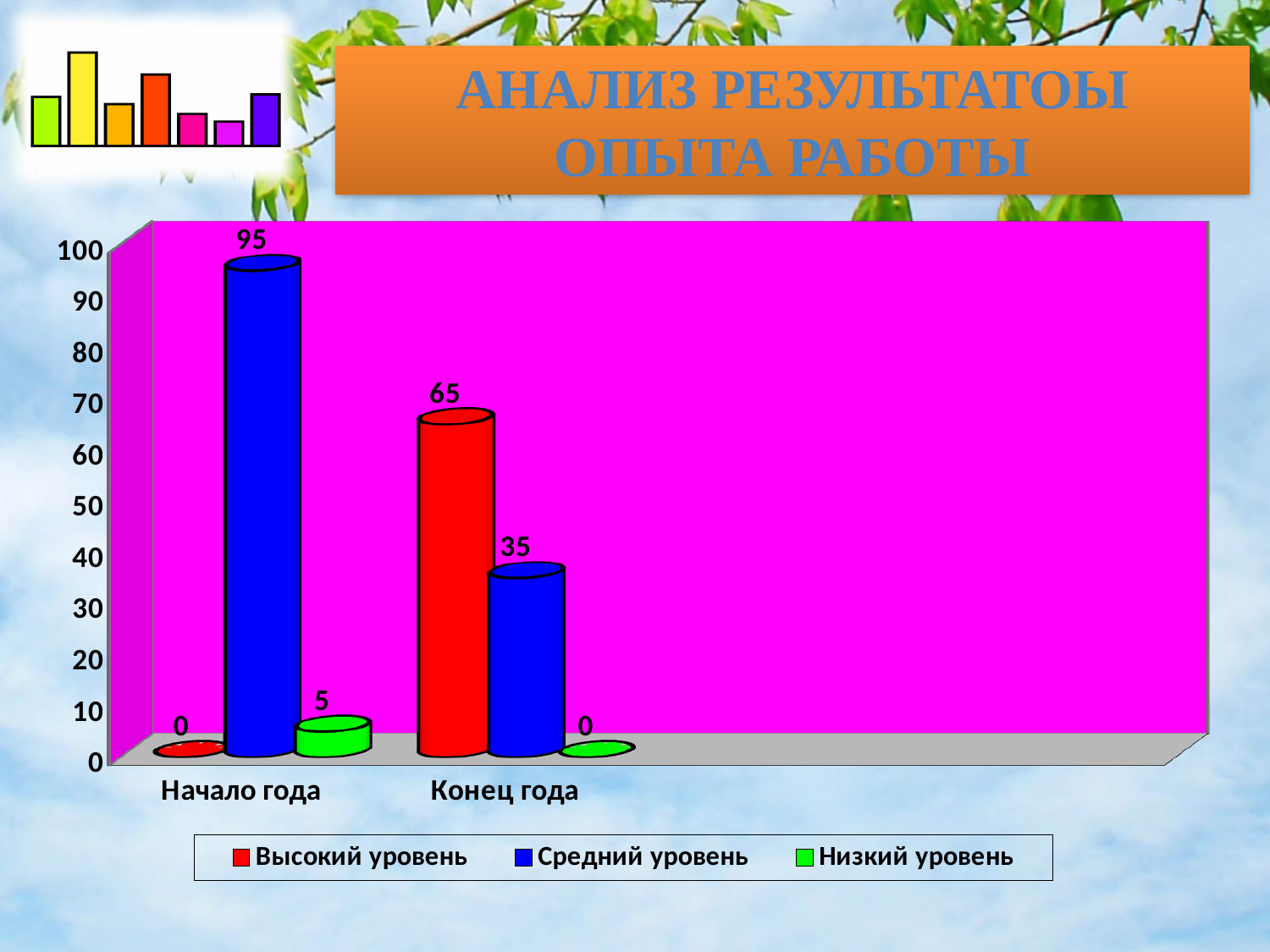
Which series has the lowest value at Начало года? Высокий уровень What kind of chart is shown on the slide? Bar chart What is the value for Средний уровень at Начало года? 95 What is the value for Высокий уровень at Конец года? 65 What is the value for Низкий уровень at Начало года? 5 What is the value for Высокий уровень at Начало года? 0 What is the difference between Средний уровень at Начало года and Средний уровень at Конец года? 60 How many series does the legend list? 3 How many categories are shown on the x axis? 2 Which is larger: Высокий уровень at Конец года or Средний уровень at Конец года? Высокий уровень at Конец года What is the value for Средний уровень at Конец года? 35 Which series has the highest value at Конец года? Высокий уровень